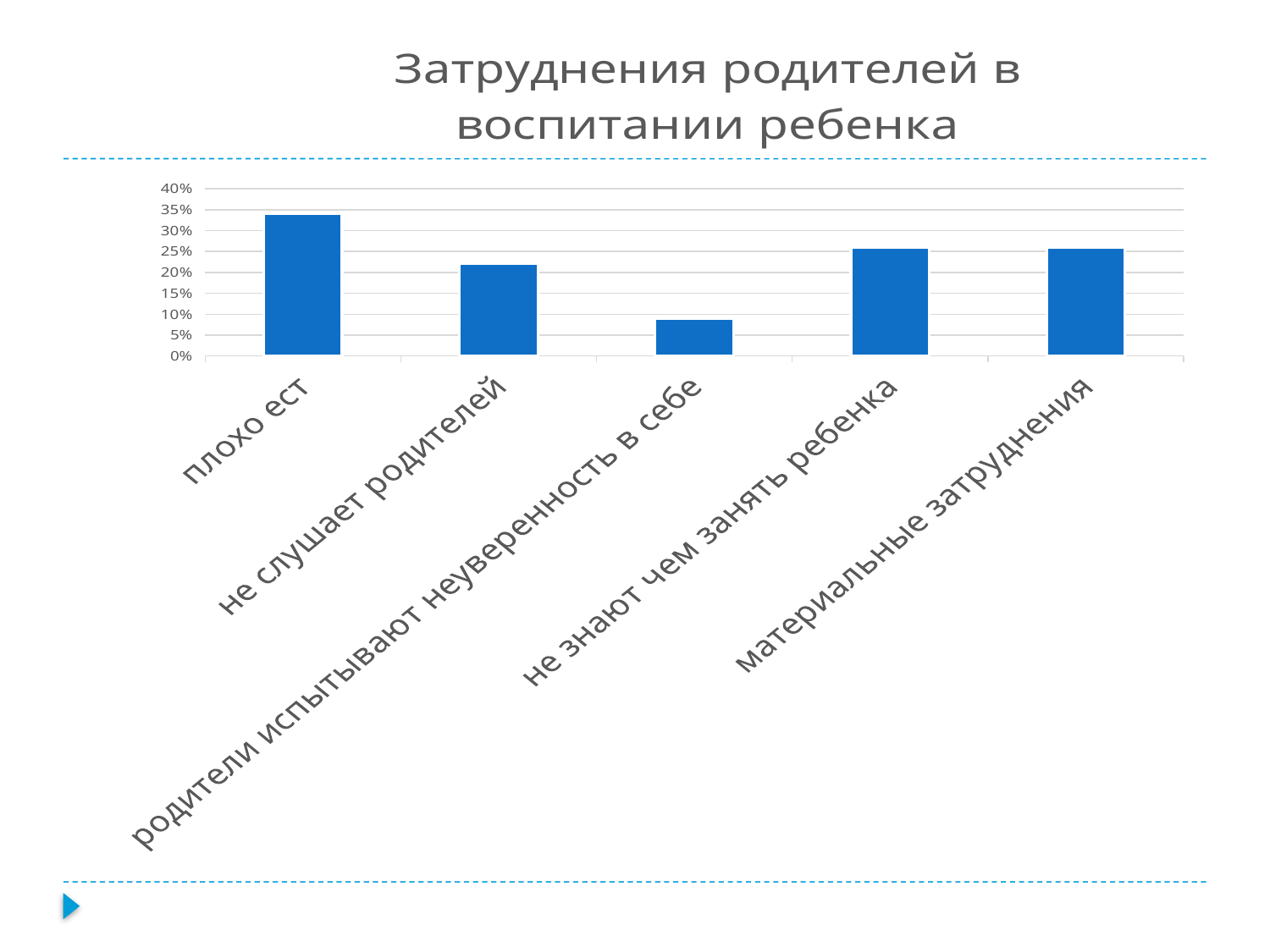
Is the value for "не слушает родителей" greater or less than 25%? less Is the value for "плохо ест" greater or less than 30%? greater Which is larger, the value for "не знают чем занять ребенка" or the value for "родители испытывают неуверенность в себе"? не знают чем занять ребенка How many categories are shown on the x axis? 5 What kind of chart is shown on the slide? bar chart Which category has the highest value? плохо ест Which category has the lowest value? родители испытывают неуверенность в себе Which is larger, the value for "плохо ест" or the value for "не слушает родителей"? плохо ест What is the title of the chart? Затруднения родителей в воспитании ребенка Is the value for "не знают чем занять ребенка" greater or less than 20%? greater